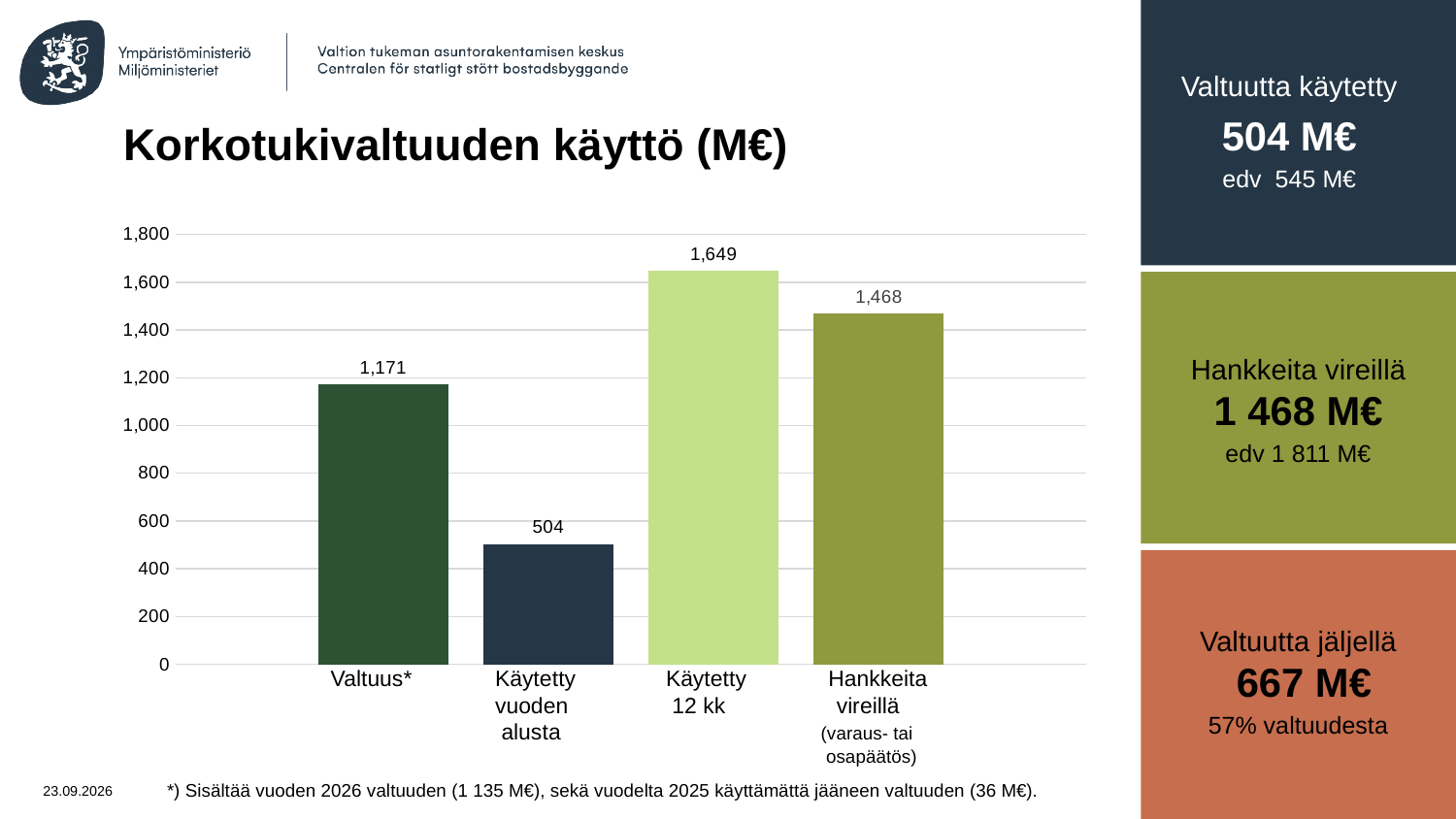
What is the value for Käytetty 12 kk? 1,649 Which category has the highest value? Käytetty 12 kk How many bars are shown in the chart? 4 What is the value for Käytetty vuoden alusta? 504 What is the value for Hankkeita vireillä? 1,468 What is the difference between Valtuus* and Käytetty vuoden alusta? 667 Which category has the lowest value? Käytetty vuoden alusta What is the value for Valtuus* in the chart? 1,171 What is the title of the chart? Korkotukivaltuuden käyttö (M€) What kind of chart is shown on the slide? Bar chart Which is larger, Valtuus* or Hankkeita vireillä? Hankkeita vireillä What is the difference between Käytetty 12 kk and Hankkeita vireillä? 181